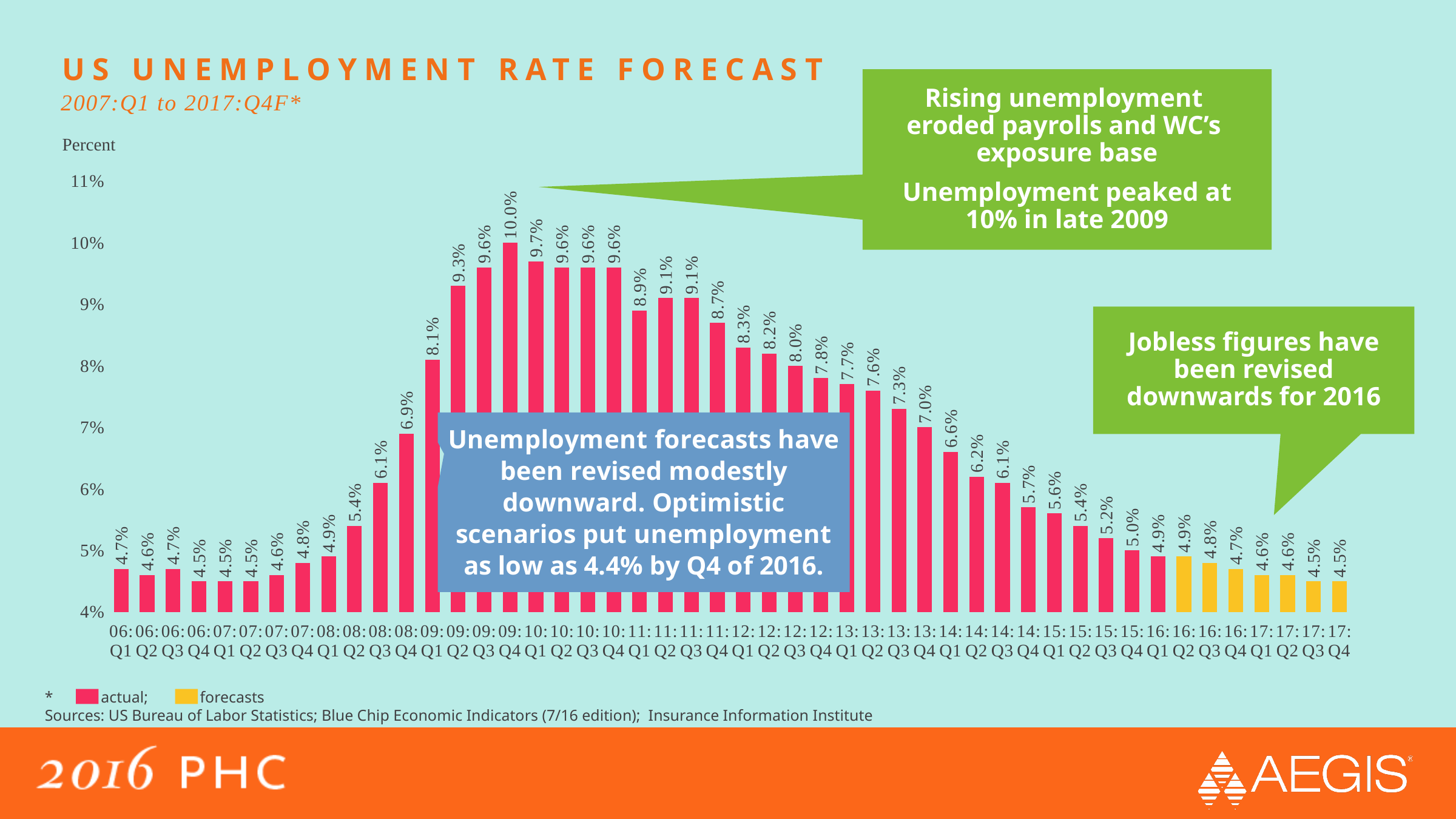
How many quarterly bars are plotted on the chart? 48 What is the unemployment rate shown for 13:Q4? 7.0% Is the unemployment rate for 14:Q1 greater or less than 6%? greater What kind of chart is shown on the slide? bar chart Which is higher, the unemployment rate in 11:Q2 or in 12:Q1? 11:Q2 How many series does the legend list? 2 What is the difference between the unemployment rate in 09:Q4 and in 16:Q1? 5.1% What is the forecast unemployment rate for 17:Q4? 4.5% Do the unemployment rates rise or fall from 13:Q1 to 17:Q4? fall What is the difference between the unemployment rate in 08:Q4 and in 09:Q1? 1.2% What is the unemployment rate shown for 09:Q4? 10.0% Which quarter has the highest unemployment rate on the chart? 09:Q4